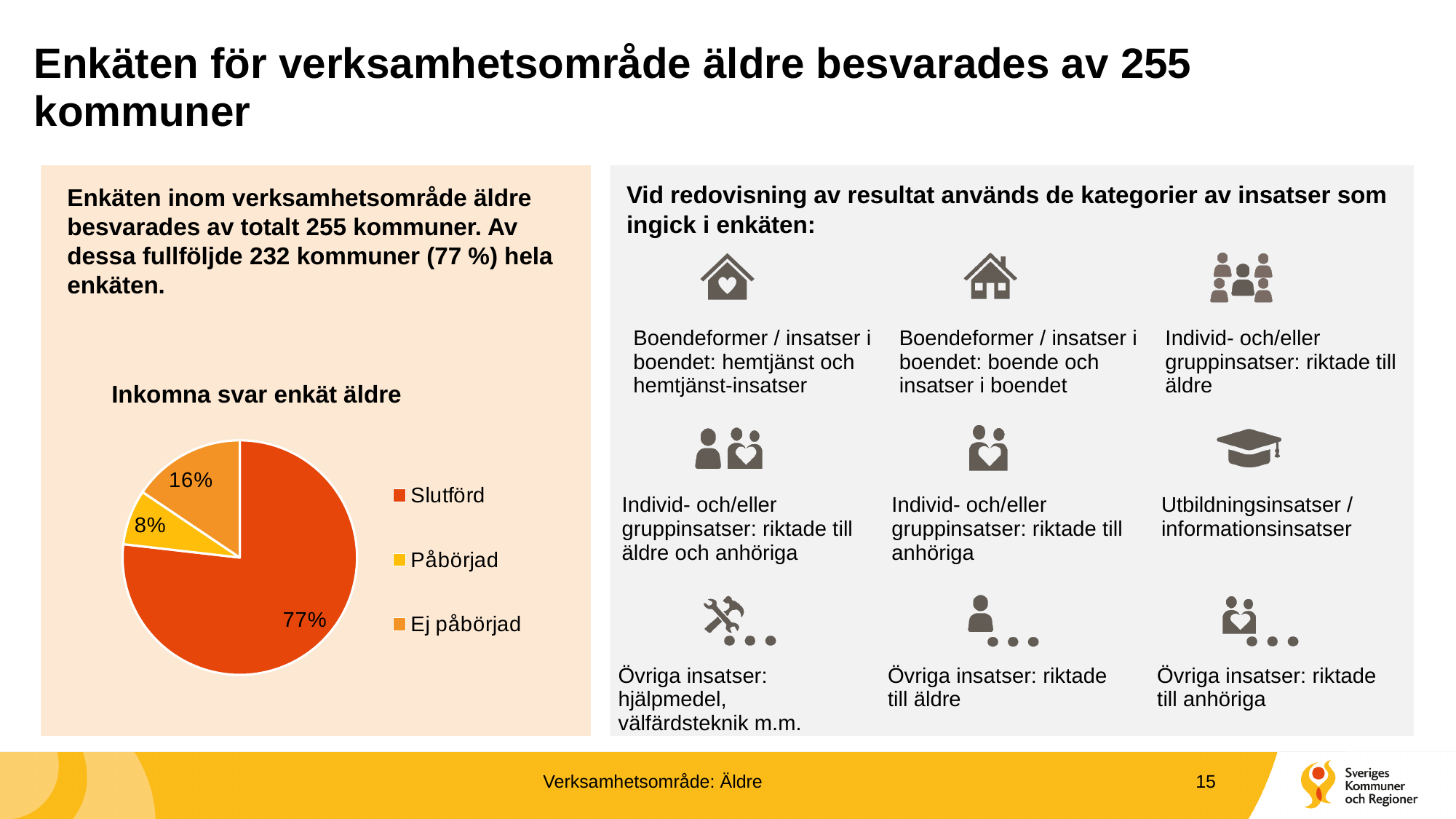
Which category has the largest slice of the pie? Slutförd What is the difference in percentage points between Slutförd and Ej påbörjad? 61 What colour is the Påbörjad slice? yellow Which category has the smallest slice of the pie? Påbörjad What kind of chart is shown on the slide? pie chart How many slices does the pie chart have? 3 What share of the pie does Påbörjad have? 8% How many entries does the legend list? 3 What share of the pie does Slutförd have? 77% What share of the pie does Ej påbörjad have? 16% Which is larger, Ej påbörjad or Påbörjad? Ej påbörjad What is the title of the chart? Inkomna svar enkät äldre